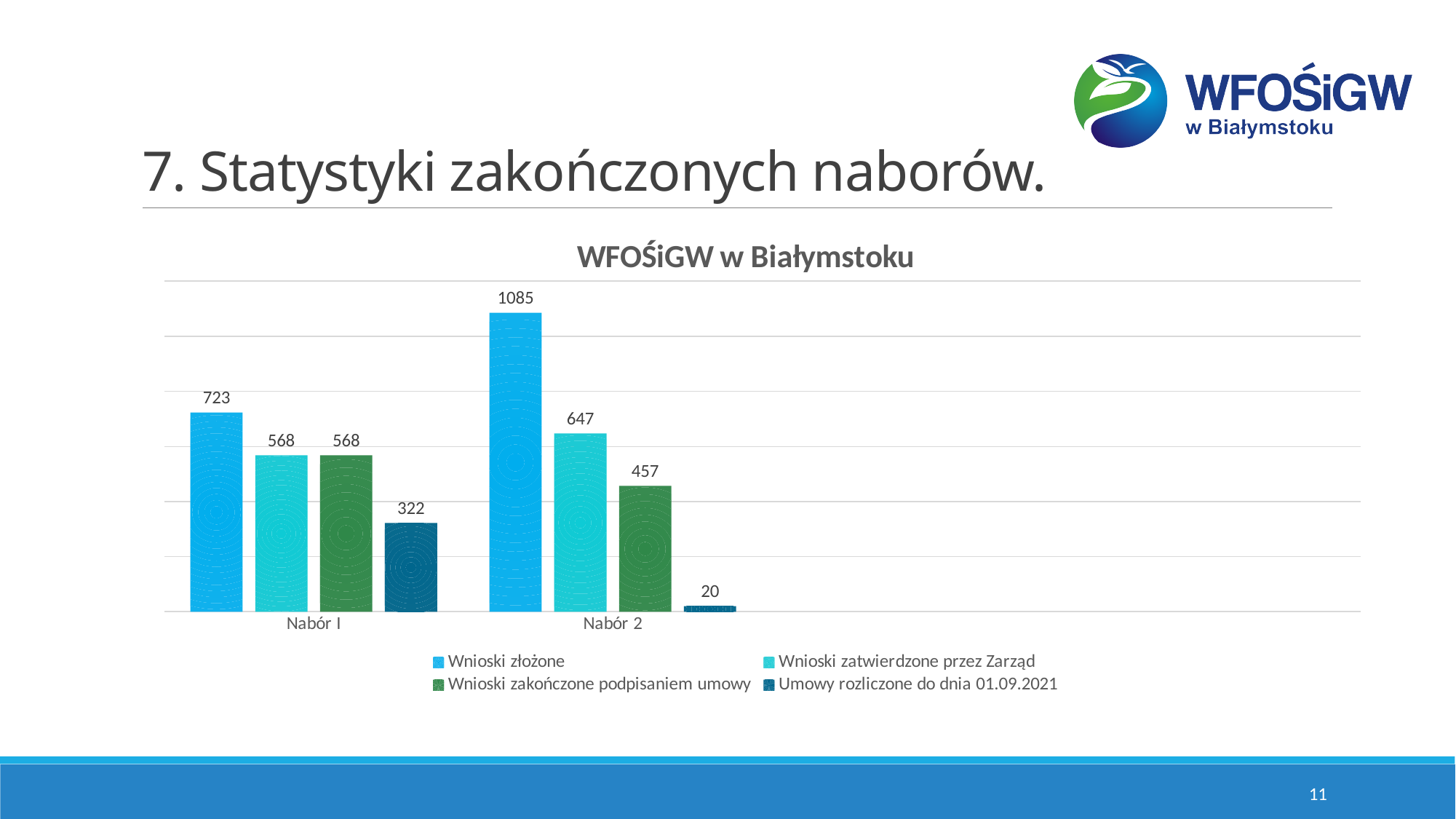
Which is larger: "Wnioski zatwierdzone przez Zarząd" for Nabór I or for Nabór 2? Nabór 2 What is the value of "Wnioski złożone" for Nabór 2? 1085 What kind of chart is shown on the slide? Bar chart What is the value of "Wnioski zakończone podpisaniem umowy" for Nabór 2? 457 What is the difference between "Umowy rozliczone do dnia 01.09.2021" for Nabór I and for Nabór 2? 302 What is the value of "Wnioski zatwierdzone przez Zarząd" for Nabór I? 568 Which series has the highest value for Nabór 2? Wnioski złożone How many categories are shown on the x axis? 2 What is the difference between "Wnioski złożone" for Nabór 2 and for Nabór I? 362 Which series has the lowest value for Nabór 2? Umowy rozliczone do dnia 01.09.2021 What is the value of "Umowy rozliczone do dnia 01.09.2021" for Nabór I? 322 How many series does the legend list? 4